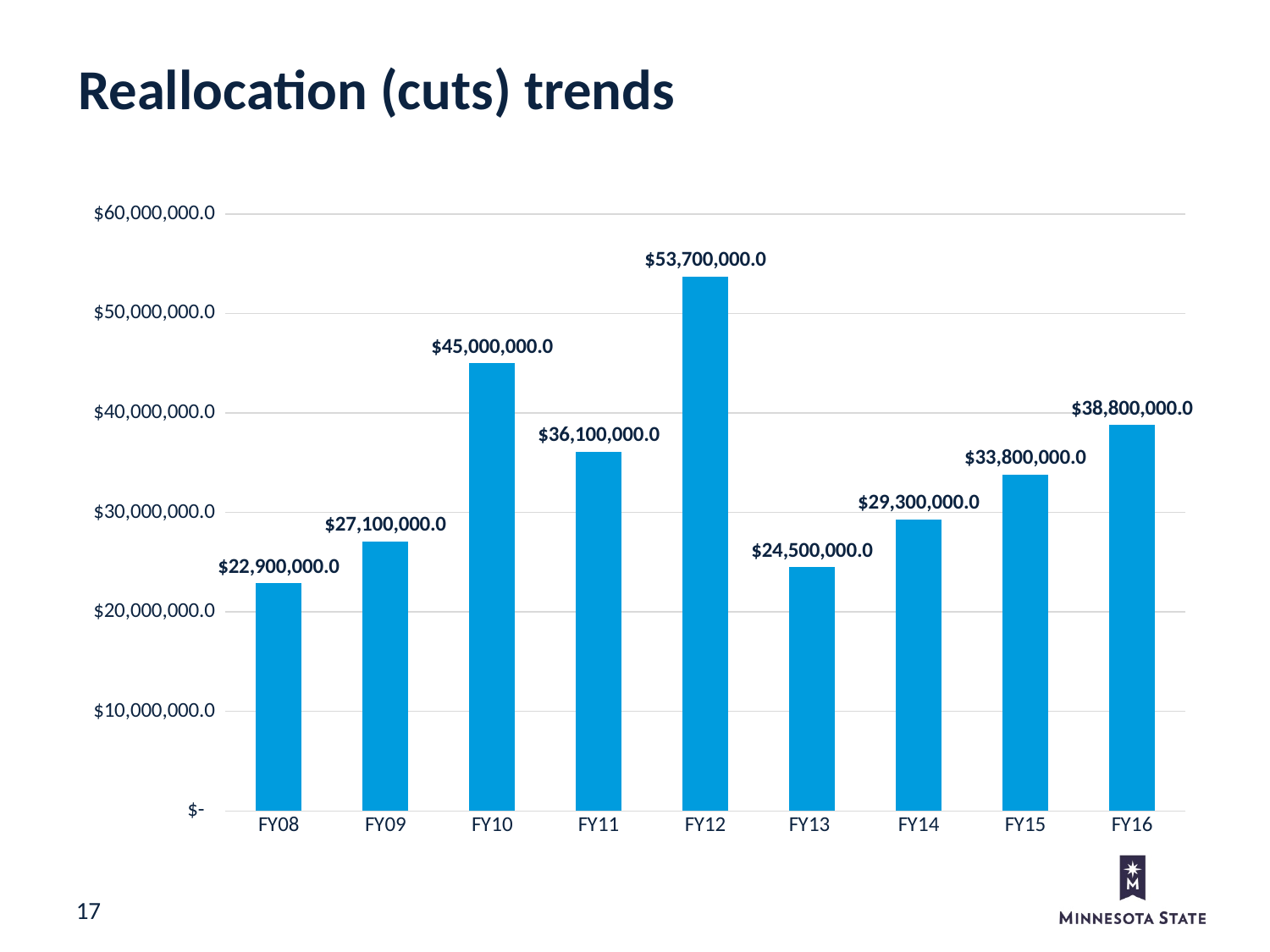
Which is larger, the value for FY10 or the value for FY11? FY10 How many fiscal years are shown on the x axis? 9 What is the difference between the values for FY16 and FY15? $5,000,000.0 Which fiscal year has the lowest value? FY08 What kind of chart is shown on the slide? bar chart What is the value for FY14? $29,300,000.0 What is the title of the slide? Reallocation (cuts) trends What is the difference between the values for FY12 and FY13? $29,200,000.0 Is the value for FY13 greater or less than $30,000,000.0? less What is the value for FY08? $22,900,000.0 Which fiscal year has the highest value? FY12 What is the value for FY12? $53,700,000.0